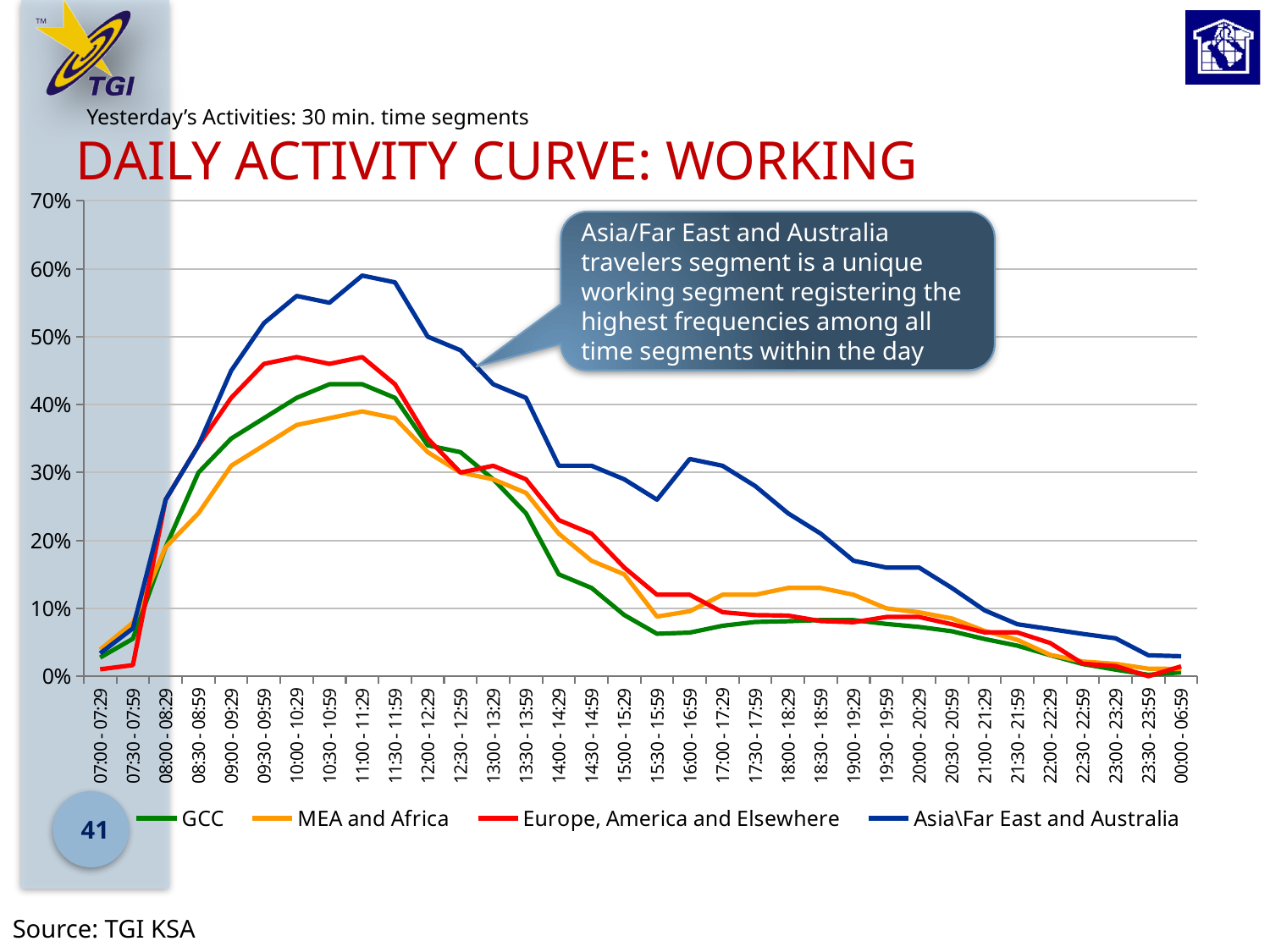
Is the value for GCC at 15:30 - 15:59 greater or less than 10%? less Does the Asia\Far East and Australia line rise or fall between 11:00 - 11:29 and 15:30 - 15:59? fall Is the value for MEA and Africa at 18:30 - 18:59 greater or less than 10%? greater At 16:00 - 16:59, which is larger: the value for Asia\Far East and Australia or the value for GCC? Asia\Far East and Australia At 11:00 - 11:29, which is larger: the value for Asia\Far East and Australia or the value for GCC? Asia\Far East and Australia What is the title of the chart? DAILY ACTIVITY CURVE: WORKING Is the value for Europe, America and Elsewhere at 10:00 - 10:29 greater or less than 40%? greater How many series does the legend list? 4 Which series reaches the highest value on the chart? Asia\Far East and Australia How many time segments are shown on the x axis? 34 What kind of chart is shown on the slide? line chart